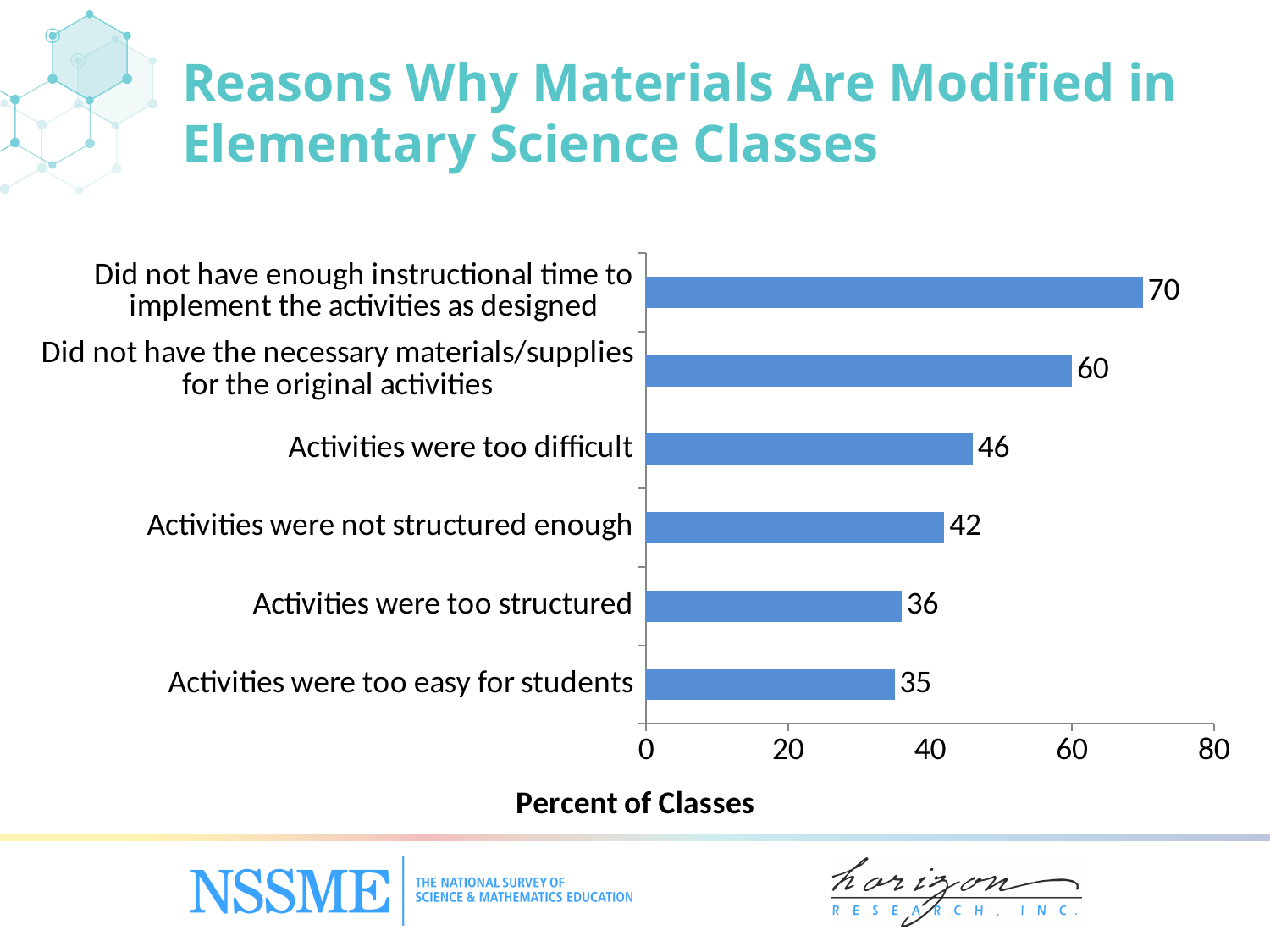
Which is larger: the value for 'Activities were not structured enough' or 'Activities were too structured'? Activities were not structured enough What kind of chart is shown on the slide? bar chart What is the label of the horizontal axis? Percent of Classes Which reason has the highest percent of classes? Did not have enough instructional time to implement the activities as designed How many reasons are shown in the chart? 6 What is the value for 'Activities were too structured'? 36 Is the value for 'Activities were too easy for students' greater or less than 40? less Which reason has the lowest percent of classes? Activities were too easy for students What is the difference between 'Activities were too difficult' and 'Activities were not structured enough'? 4 What percent of classes reported 'Activities were too difficult' as a reason for modifying materials? 46 What is the difference between the values for 'Did not have enough instructional time to implement the activities as designed' and 'Did not have the necessary materials/supplies for the original activities'? 10 What percent of classes did not have the necessary materials/supplies for the original activities? 60